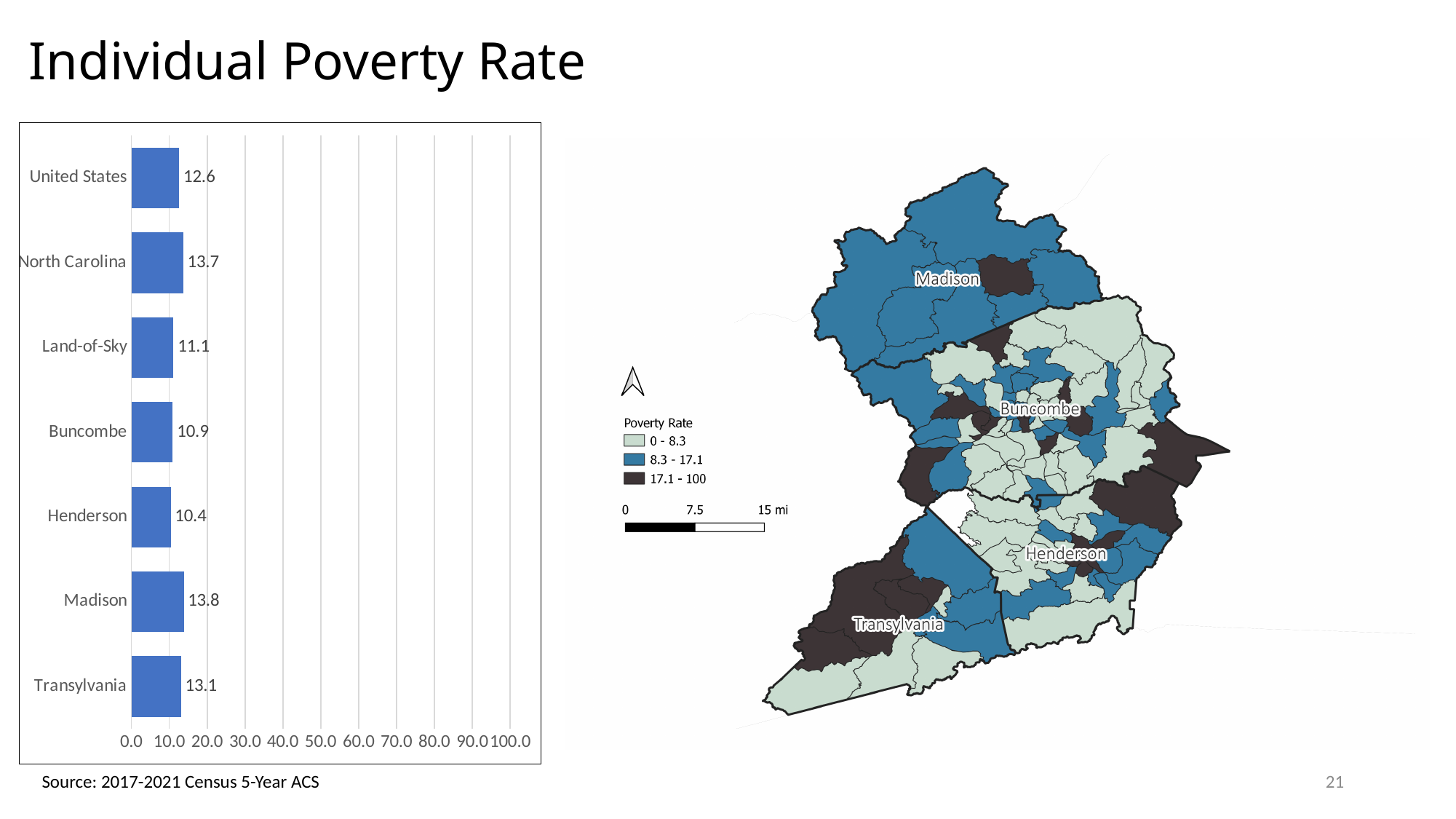
Which has a higher value in the bar chart, Transylvania or Buncombe? Transylvania What is the value for Henderson in the bar chart? 10.4 What is the difference between the values for North Carolina and the United States in the bar chart? 1.1 Which category has the lowest value in the bar chart? Henderson What is the difference between the values for Madison and Henderson in the bar chart? 3.4 What is the individual poverty rate shown for the United States in the bar chart? 12.6 How many categories are shown in the bar chart? 7 What kind of chart is on the left side of the slide? Bar chart What is the value for North Carolina in the bar chart? 13.7 Which category has the highest value in the bar chart? Madison What is the maximum value shown on the x axis of the bar chart? 100.0 What is the value for Land-of-Sky in the bar chart? 11.1